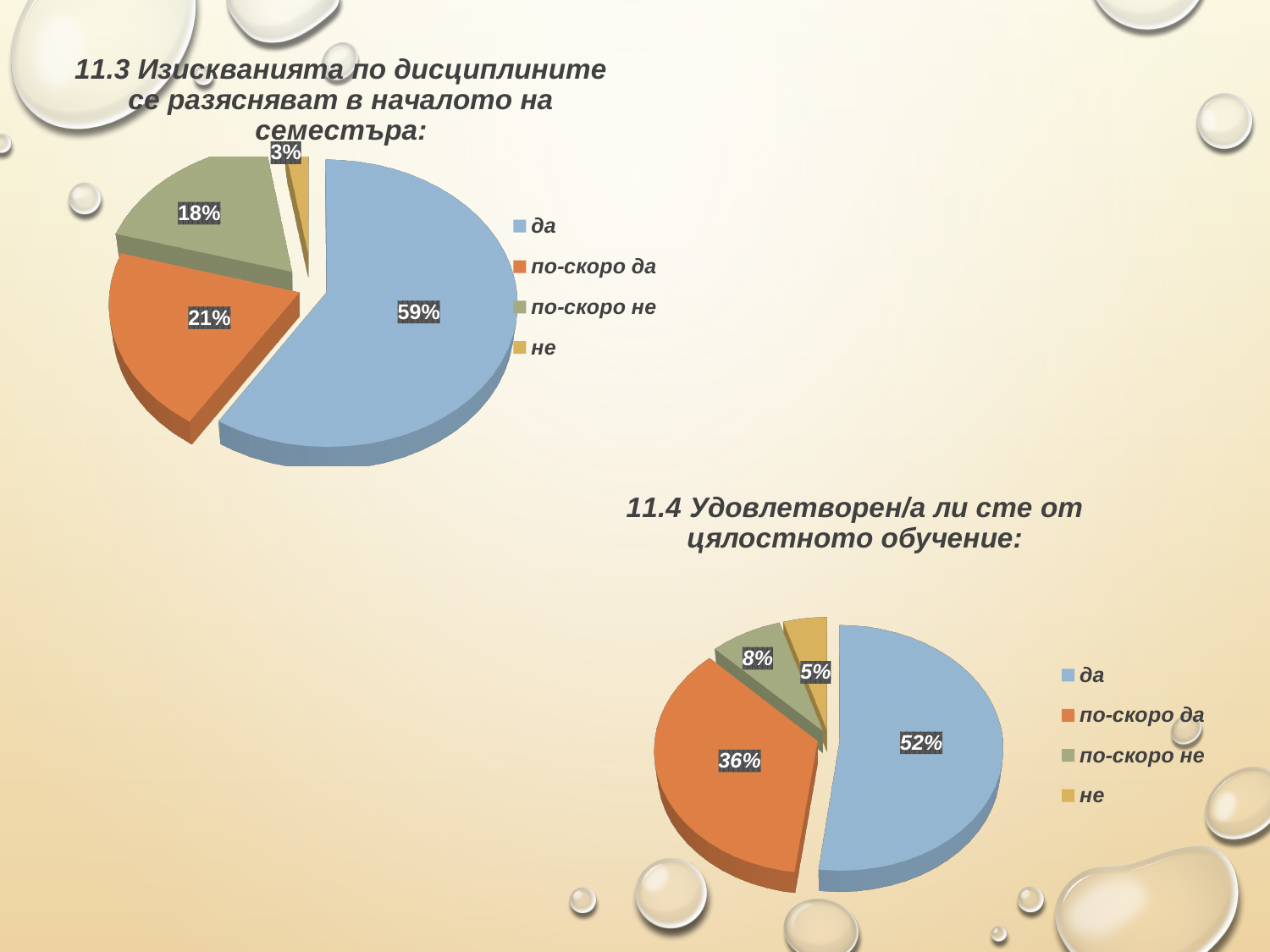
In the chart titled "11.4 Удовлетворен/а ли сте от цялостното обучение", what is the difference between "да" and "по-скоро да"? 16% In the chart titled "11.3 Изискванията по дисциплините се разясняват в началото на семестъра", what share does "по-скоро не" have? 18% In the chart titled "11.4 Удовлетворен/а ли сте от цялостното обучение", what share does "по-скоро да" have? 36% In the chart titled "11.3 Изискванията по дисциплините се разясняват в началото на семестъра", how many slices does the pie have? 4 In the chart titled "11.3 Изискванията по дисциплините се разясняват в началото на семестъра", what is the difference between "да" and "по-скоро да"? 38% What type of chart is used for "11.4 Удовлетворен/а ли сте от цялостното обучение"? Pie chart In the chart titled "11.4 Удовлетворен/а ли сте от цялостното обучение", what share does "не" have? 5% In the chart titled "11.3 Изискванията по дисциплините се разясняват в началото на семестъра", which category has the smallest slice? не In the chart titled "11.3 Изискванията по дисциплините се разясняват в началото на семестъра", what colour is the "по-скоро да" slice? Orange In the chart titled "11.4 Удовлетворен/а ли сте от цялостното обучение", which is larger, "по-скоро не" or "не"? по-скоро не In the chart titled "11.3 Изискванията по дисциплините се разясняват в началото на семестъра", what share does "да" have? 59% In the chart titled "11.4 Удовлетворен/а ли сте от цялостното обучение", which category has the largest slice? да